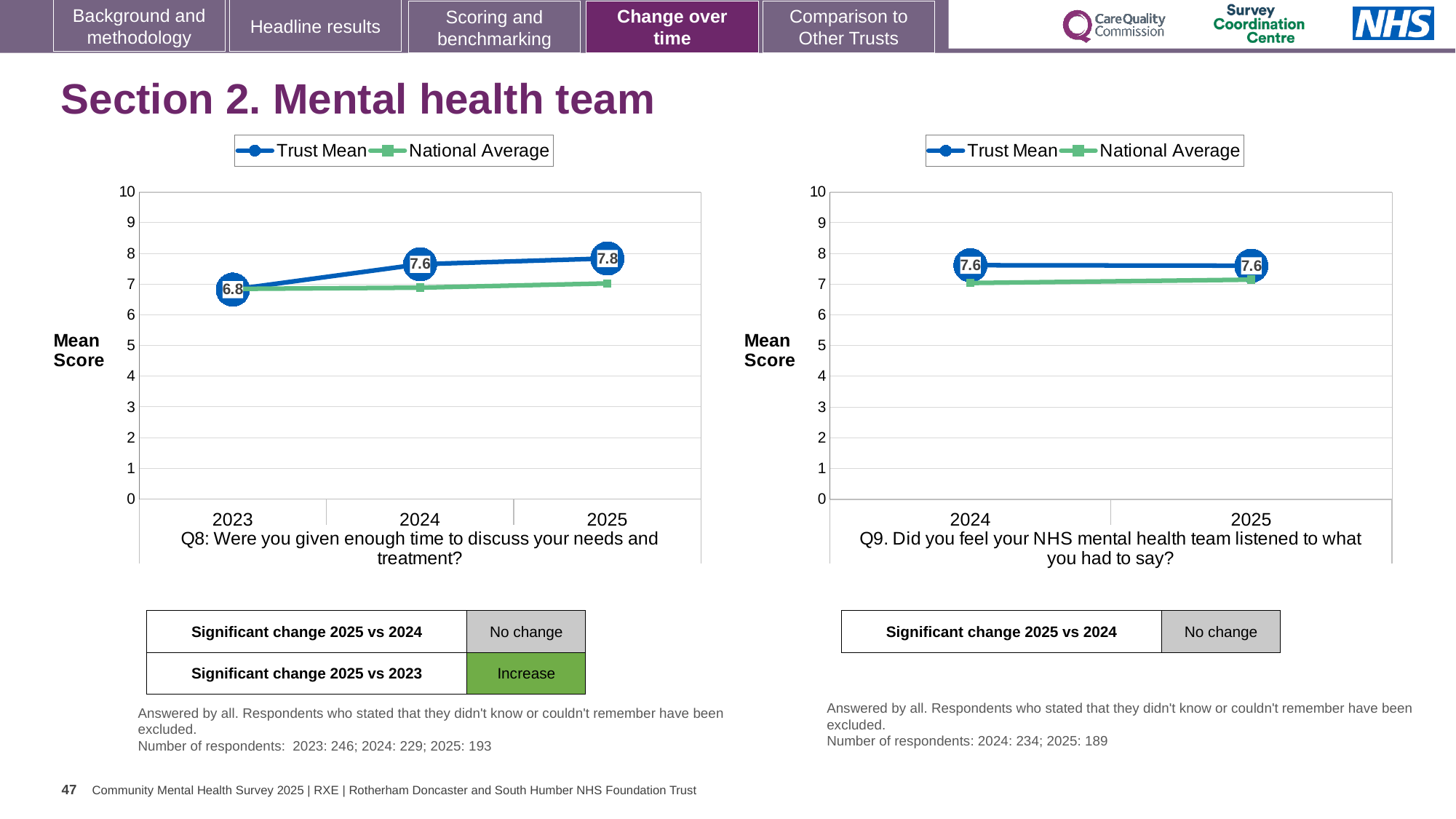
In the Q9 chart (right), what is the Trust Mean score for 2024? 7.6 In the Q8 chart (left), what is the difference between the Trust Mean scores for 2025 and 2023? 1.0 What type of chart is used for Q8 (left)? Line chart In the Q8 chart (left), what is the Trust Mean score for 2023? 6.8 In the Q8 chart (left), which year has the highest Trust Mean score? 2025 In the Q9 chart (right), is the National Average for 2024 greater or less than 8? less How many series does the legend of the Q9 chart (right) list? 2 In the Q8 chart (left), which year has the lowest Trust Mean score? 2023 In the Q8 chart (left), what is the Trust Mean score for 2025? 7.8 In the Q9 chart (right), is the Trust Mean for 2025 higher or lower than the National Average for 2025? higher How many years are shown on the x axis of the Q8 chart (left)? 3 In the Q8 chart (left), is the Trust Mean score for 2024 greater or less than 7? greater